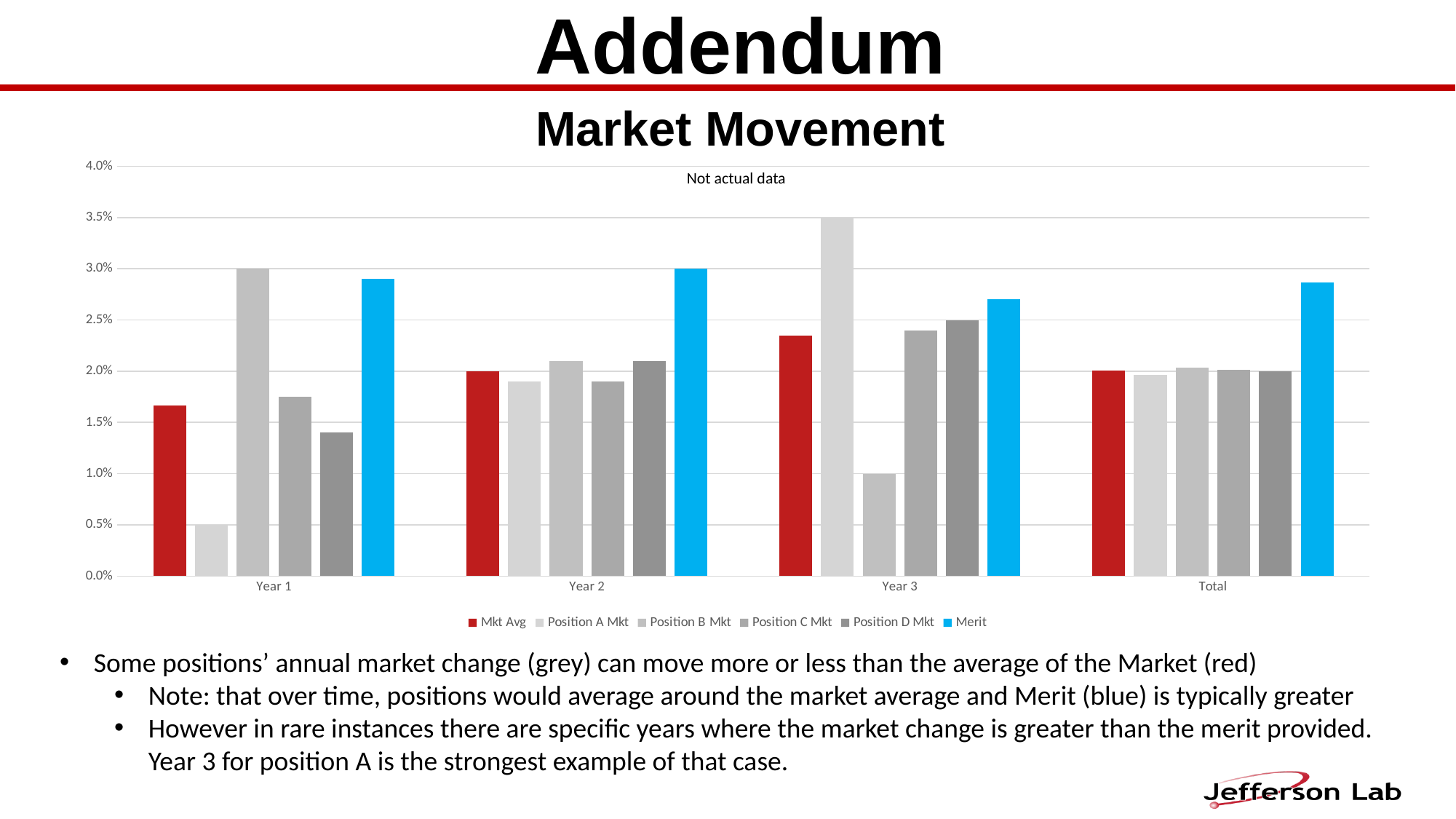
How many series does the legend list? 6 Which series has the lowest value in Year 1? Position A Mkt How many categories are shown on the x axis? 4 Is the value for Merit in Year 1 greater or less than 2.5%? greater What type of chart is shown on the slide? bar chart Which is larger in Year 2: Merit or Mkt Avg? Merit What is the title of the chart? Market Movement Which series has the lowest value in Year 3? Position B Mkt Is the value for Mkt Avg in Year 3 greater or less than 2.0%? greater Which series has the highest value in Year 1? Position B Mkt Is the value for Position A Mkt in Year 1 greater or less than 1.0%? less Which series has the highest value in Year 3? Position A Mkt